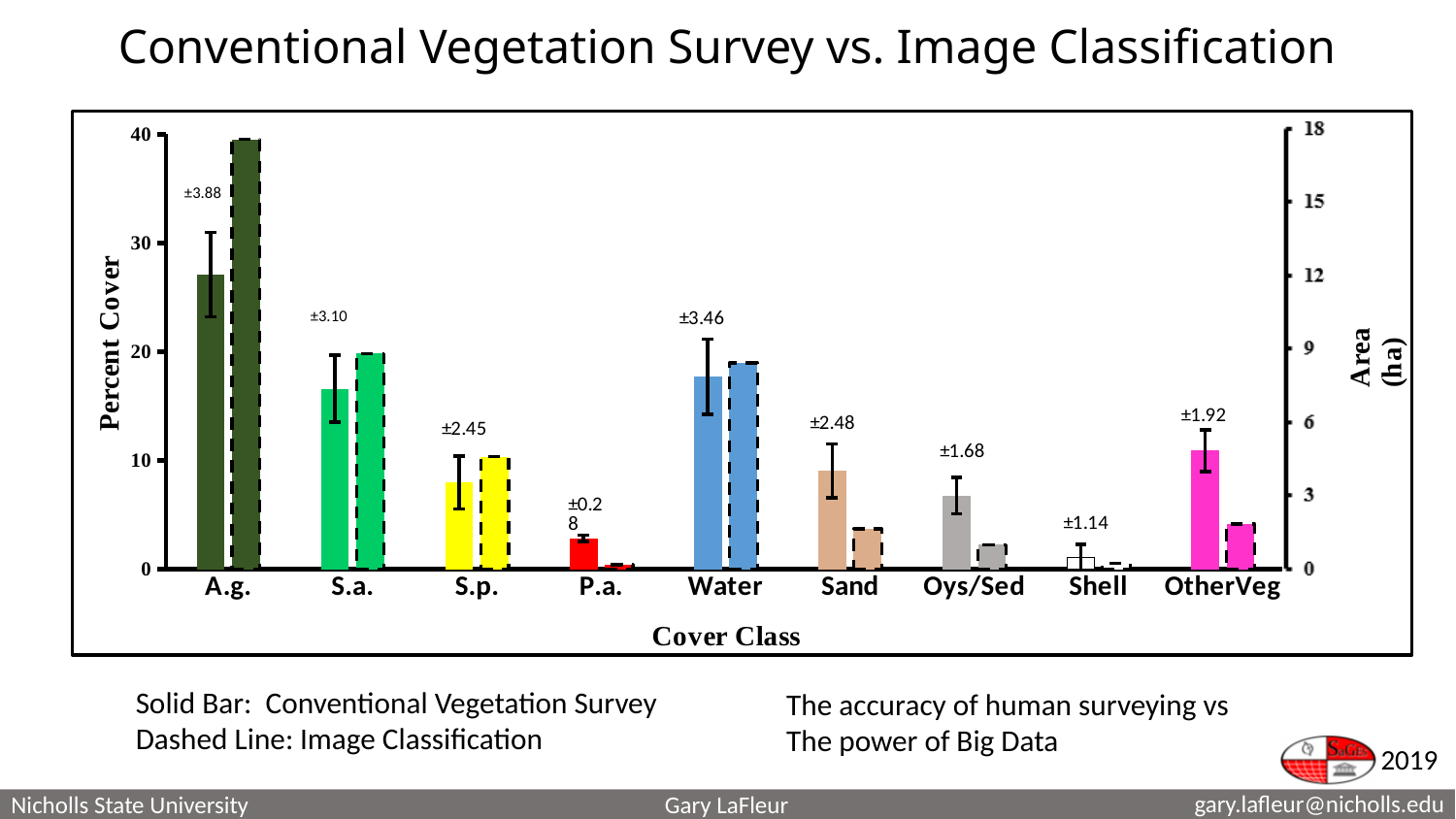
Which cover class has the highest dashed bar (Image Classification)? A.g. Which has the larger solid bar, A.g. or Water? A.g. What error value is printed above the Water bars? ±3.46 Which cover class has the highest solid bar (Conventional Vegetation Survey)? A.g. Is the solid bar for Sand greater or less than 10 percent cover? less What error value is printed above the Shell bars? ±1.14 Which cover class has the lowest solid bar (Conventional Vegetation Survey)? Shell How many cover classes are shown on the x axis? 9 What kind of chart is shown on the slide? bar chart What is the title of the x axis? Cover Class What error value is printed above the A.g. bars? ±3.88 Is the solid bar for A.g. greater or less than 20 percent cover? greater